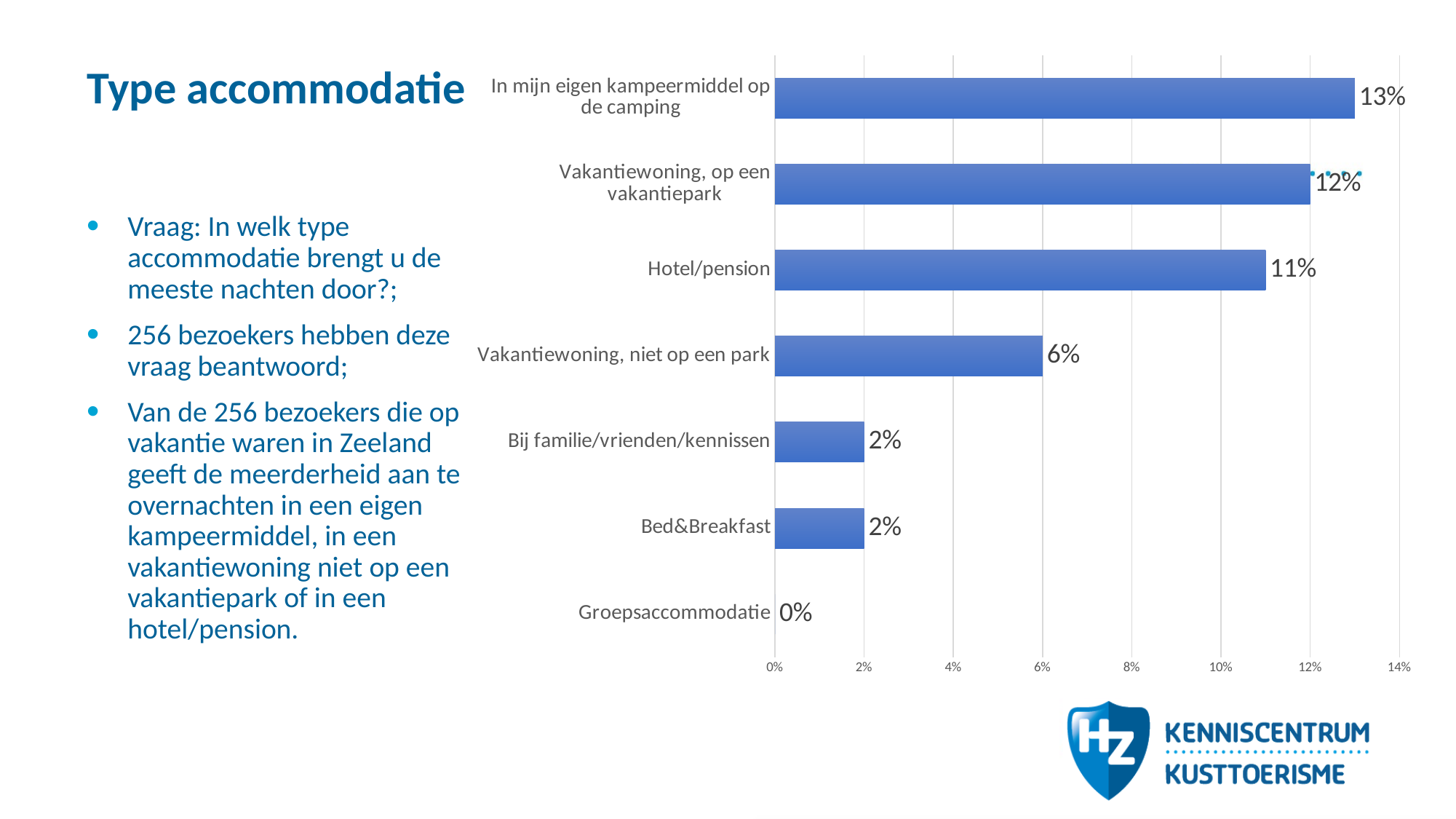
Is the value for 'Vakantiewoning, niet op een park' greater or less than 10%? less Which category has the lowest value? Groepsaccommodatie What is the title of the slide containing the chart? Type accommodatie How many categories are shown in the chart? 7 Which is larger: the value for 'Vakantiewoning, op een vakantiepark' or the value for 'Hotel/pension'? Vakantiewoning, op een vakantiepark What kind of chart is shown on the slide? bar chart What is the value for 'Vakantiewoning, niet op een park'? 6% What is the value for 'Groepsaccommodatie'? 0% Which category has the highest value? In mijn eigen kampeermiddel op de camping What is the value for 'In mijn eigen kampeermiddel op de camping'? 13% What is the value for 'Hotel/pension'? 11% What is the difference between the values for 'Hotel/pension' and 'Vakantiewoning, niet op een park'? 5%